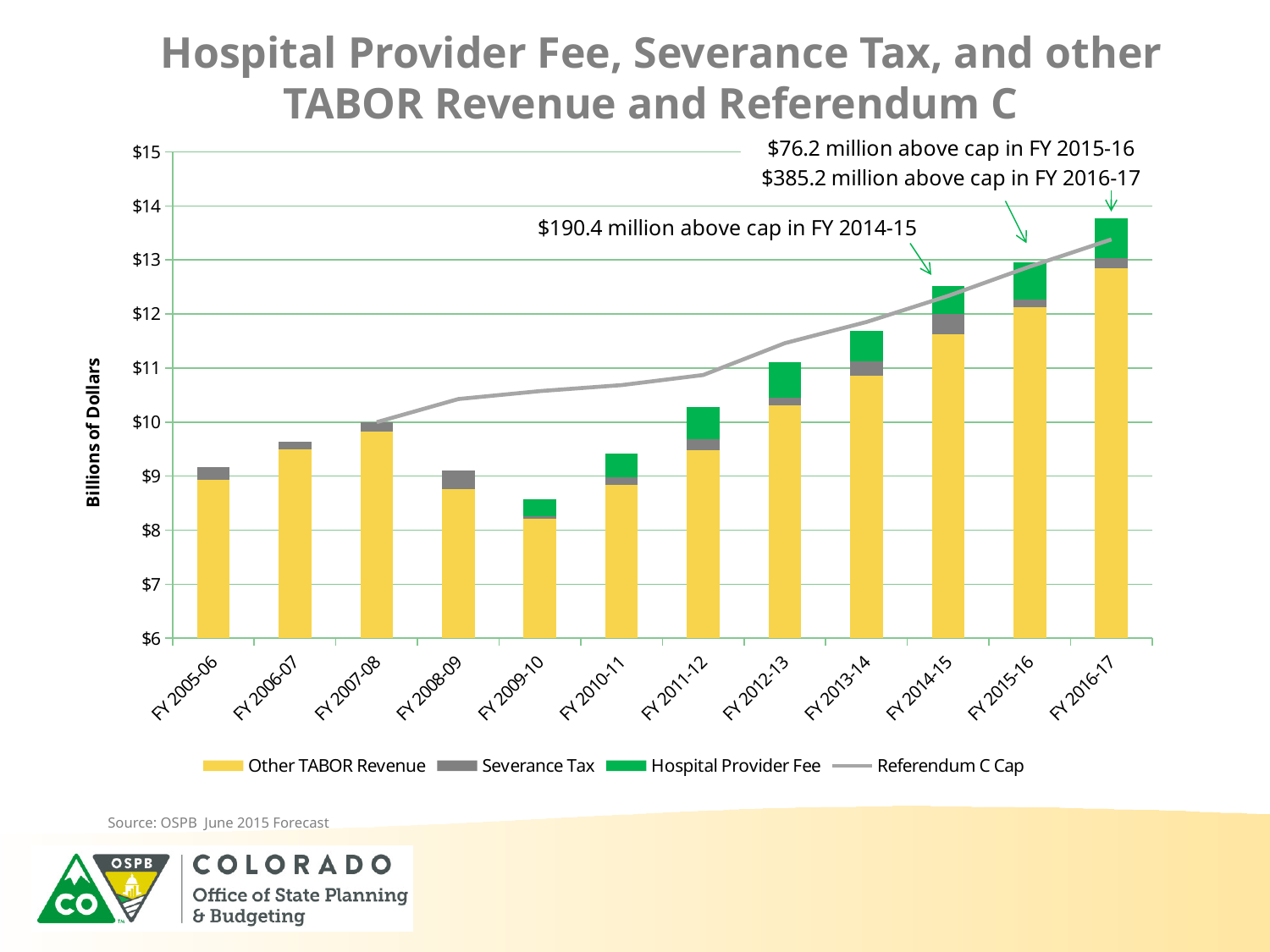
How much larger is the amount above the cap in FY 2016-17 than in FY 2015-16? $309.0 million According to the annotation, how much revenue was above the cap in FY 2016-17? $385.2 million How many fiscal years are shown on the x axis? 12 Is the total stacked bar for FY 2016-17 greater or less than $13 billion? greater Is the total stacked bar for FY 2009-10 greater or less than $9 billion? less Which fiscal year has the shortest stacked bar? FY 2009-10 Which fiscal year has the tallest stacked bar? FY 2016-17 What kind of chart is shown on the slide? Bar chart (stacked bars with a line) According to the annotation, how much revenue was above the cap in FY 2014-15? $190.4 million How many series does the legend list? 4 What is the label on the y axis? Billions of Dollars According to the annotation, how much revenue was above the cap in FY 2015-16? $76.2 million